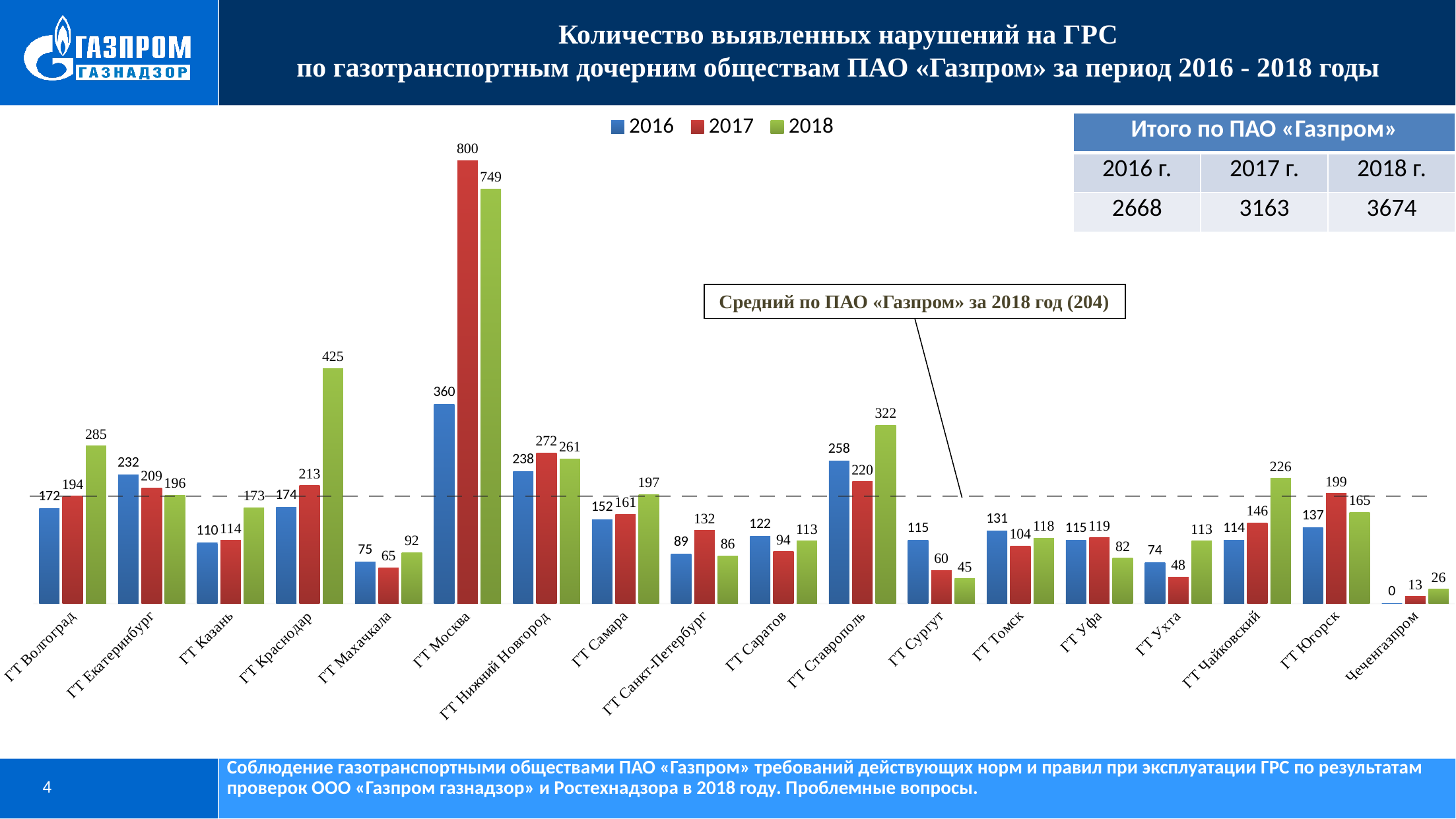
What is the difference between the 2017 and 2018 values for ГТ Москва? 51 What is the average value for ПАО «Газпром» in 2018 indicated by the dashed line? 204 Which category has the highest value in the 2017 series? ГТ Москва What is the value for ГТ Чайковский in 2018? 226 How many categories (subsidiaries) are shown along the x axis? 18 Which category has the lowest value in the 2018 series? Чеченгазпром How many series does the legend list? 3 What is the total for ПАО «Газпром» in 2017 according to the table on the slide? 3163 What type of chart is shown on the slide? bar chart Which is larger: the 2018 value for ГТ Краснодар or the 2018 value for ГТ Ставрополь? ГТ Краснодар Do the values for ГТ Волгоград rise or fall from 2016 to 2018? rise What is the value for ГТ Махачкала in 2017? 65